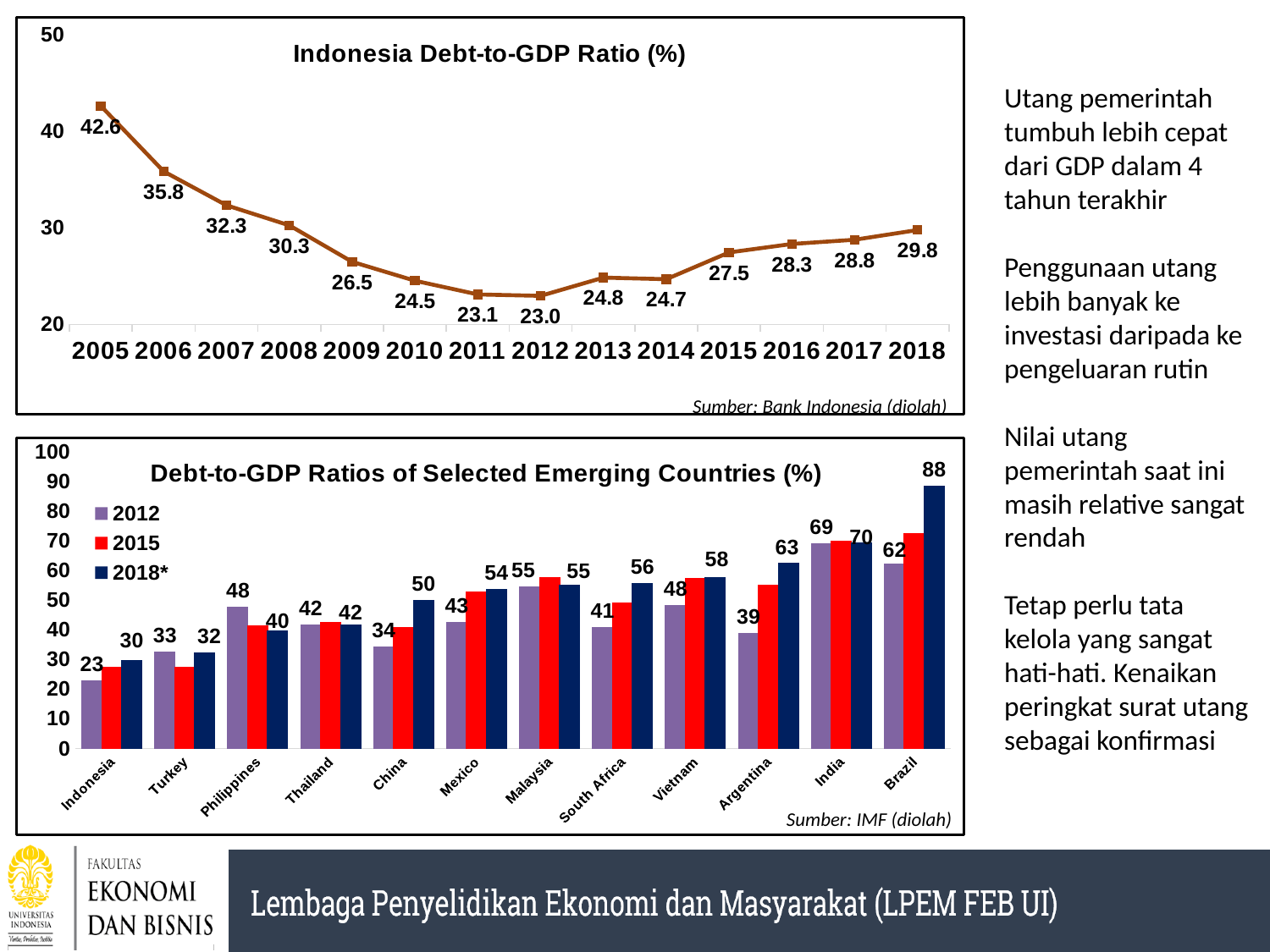
In the Indonesia Debt-to-GDP Ratio (%) chart, what is the difference between the 2005 and 2012 values? 19.6 In the Indonesia Debt-to-GDP Ratio (%) chart, which year has the lowest ratio? 2012 In the Debt-to-GDP Ratios of Selected Emerging Countries (%) chart, is the 2015 value for Argentina greater or less than 50? greater In the Debt-to-GDP Ratios of Selected Emerging Countries (%) chart, how many series does the legend list? 3 In the Indonesia Debt-to-GDP Ratio (%) chart, which year has the highest ratio? 2005 In the Indonesia Debt-to-GDP Ratio (%) chart, what was the ratio in 2018? 29.8 In the Indonesia Debt-to-GDP Ratio (%) chart, does the ratio rise or fall from 2005 to 2012? fall In the Debt-to-GDP Ratios of Selected Emerging Countries (%) chart, which country has the highest 2018* value? Brazil In the Debt-to-GDP Ratios of Selected Emerging Countries (%) chart, what is the 2018* value for Brazil? 88 In the Indonesia Debt-to-GDP Ratio (%) chart, what was the ratio in 2005? 42.6 What type of chart is the Indonesia Debt-to-GDP Ratio (%) chart? line chart In the Indonesia Debt-to-GDP Ratio (%) chart, how many years are plotted? 14